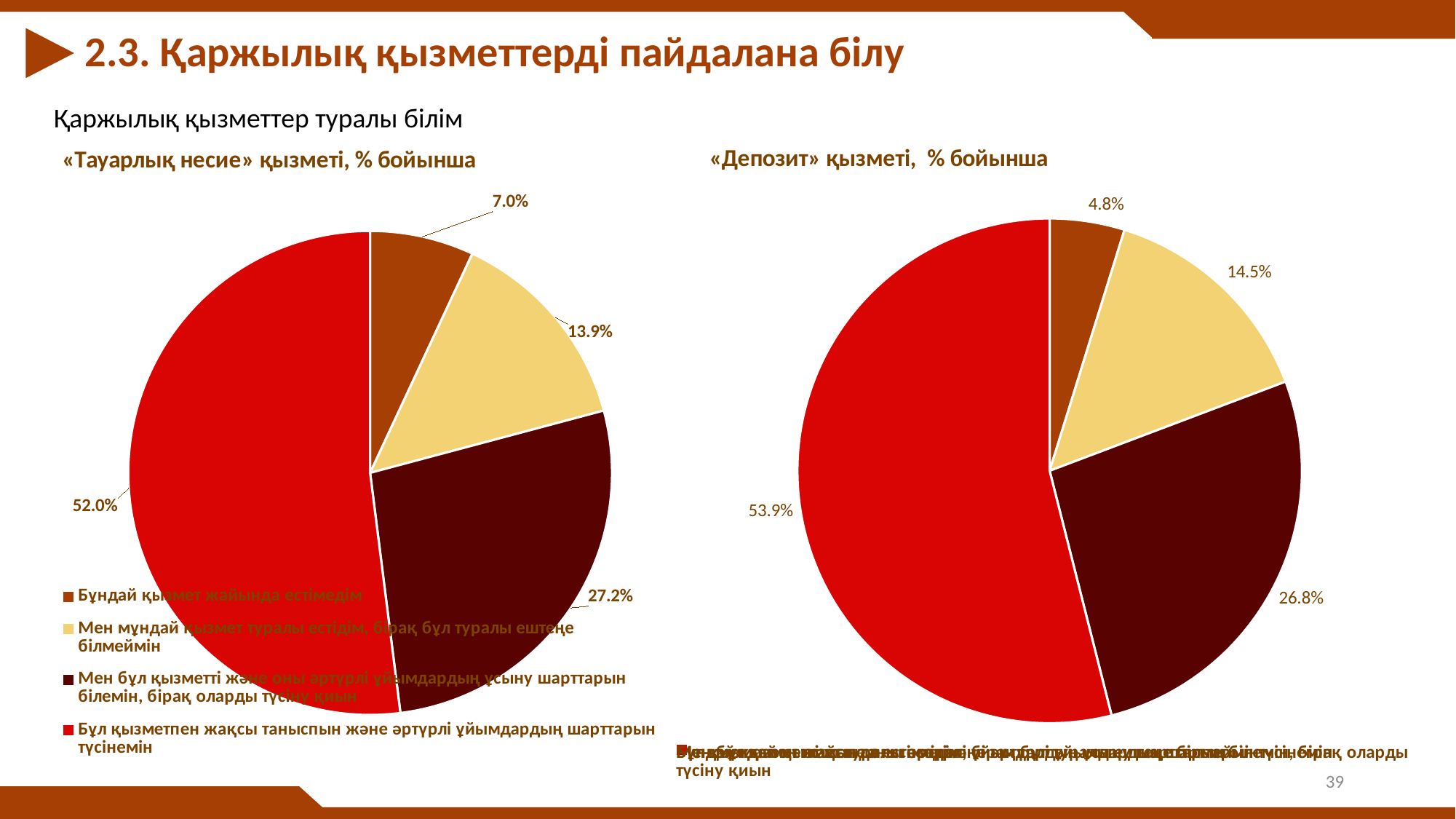
In the «Тауарлық несие» қызметі pie chart, what is the value of the smallest slice? 7.0% What type of chart is used on this slide for the «Тауарлық несие» қызметі data? Pie chart In the «Тауарлық несие» қызметі pie chart, what share is labelled for the category «Мен мұндай қызмет туралы естідім, бірақ бұл туралы ештеңе білмеймін»? 13.9% In the «Депозит» қызметі pie chart, what is the difference between the 14.5% slice and the 4.8% slice? 9.7% In the «Депозит» қызметі pie chart, what is the value of the largest slice? 53.9% In the «Депозит» қызметі pie chart, what is the value of the smallest slice? 4.8% In the «Тауарлық несие» қызметі pie chart, what share is labelled for the category «Бұндай қызмет жайында естімедім»? 7.0% In the «Тауарлық несие» қызметі pie chart, what is the value of the largest slice? 52.0% How many entries does the legend of the «Тауарлық несие» қызметі pie chart list? 4 Which is larger: the largest slice of the «Тауарлық несие» қызметі pie chart or the largest slice of the «Депозит» қызметі pie chart? «Депозит» қызметі (53.9%) In the «Тауарлық несие» қызметі pie chart, what is the difference between the 52.0% slice and the 27.2% slice? 24.8% How many slices does the «Тауарлық несие» қызметі pie chart have? 4